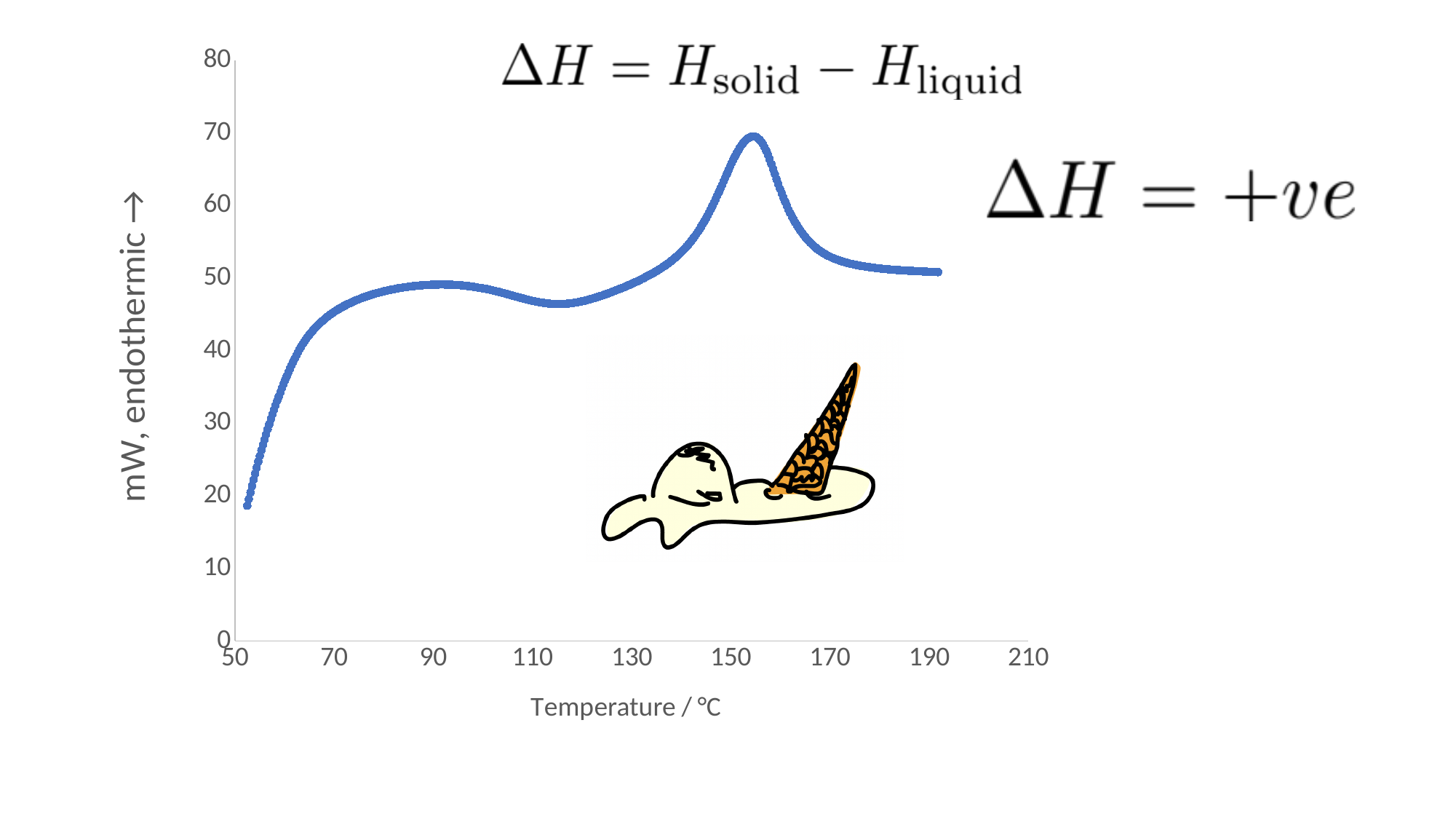
Which is larger, the value at 150 °C or the value at 70 °C? 150 °C Is the value at the start of the curve, near 50 °C, greater or less than 30? less What is the label of the y axis? mW, endothermic → Is the value at 70 °C greater or less than 50? less Is the peak value of the curve greater or less than 60? greater What kind of chart is shown on the slide? line chart How many data series are plotted on the chart? 1 Does the curve rise or fall between 50 °C and 90 °C? rise Does the curve rise or fall between 160 °C and 190 °C? fall What is the label of the x axis? Temperature / °C